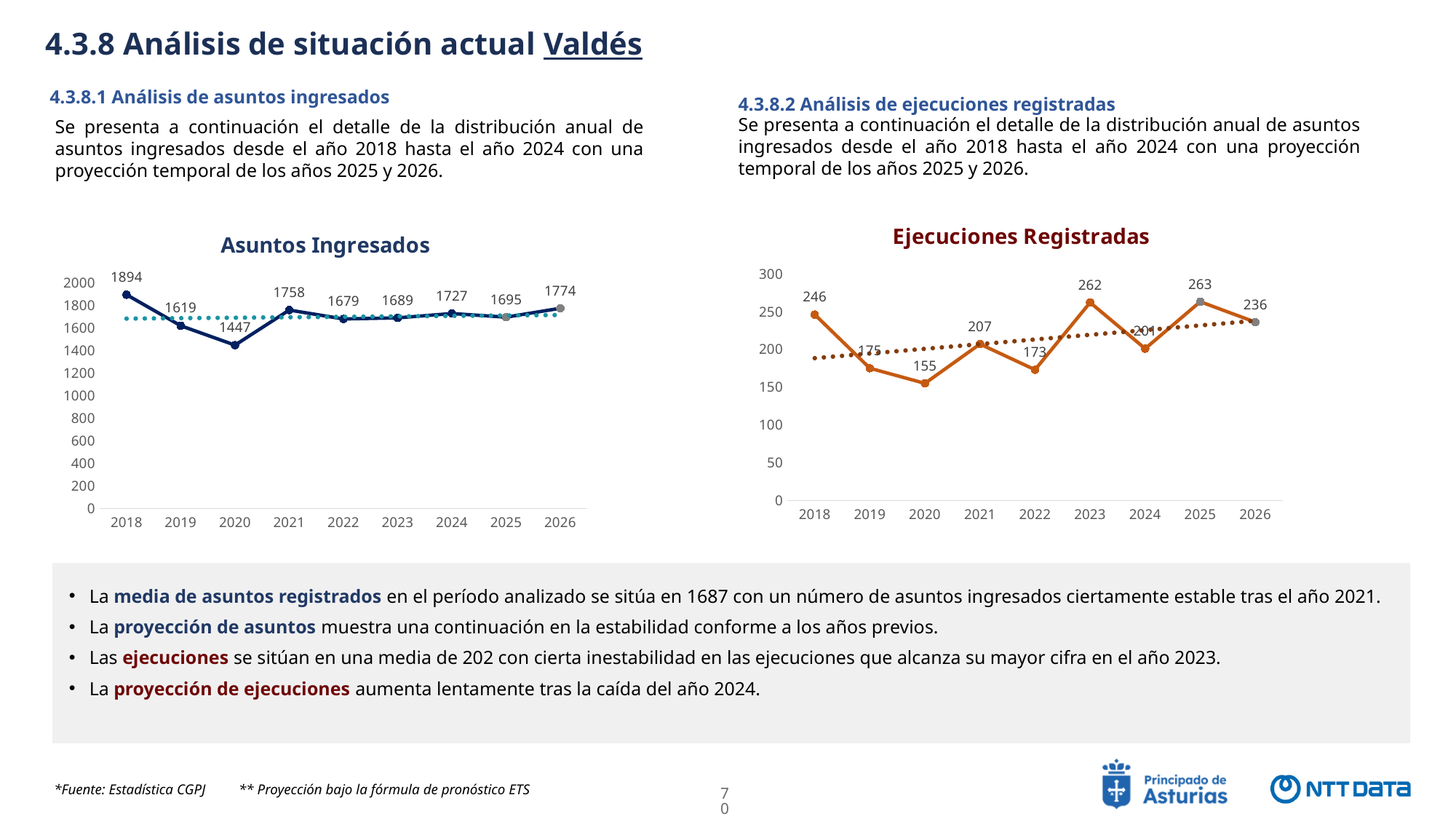
In the 'Asuntos Ingresados' chart, what is the difference between the values for 2018 and 2020? 447 In the 'Ejecuciones Registradas' chart, what is the value for 2023? 262 In the 'Asuntos Ingresados' chart, which year has the lowest value? 2020 In the 'Ejecuciones Registradas' chart, which year has the highest value? 2025 In the 'Asuntos Ingresados' chart, how many years are plotted on the x axis? 9 What kind of chart is the 'Ejecuciones Registradas' chart? Line chart In the 'Asuntos Ingresados' chart, what is the value for 2018? 1894 In the 'Asuntos Ingresados' chart, do the values rise or fall from 2019 to 2020? Fall In the 'Ejecuciones Registradas' chart, what is the difference between the values for 2025 and 2026? 27 In the 'Ejecuciones Registradas' chart, which is larger, the value for 2019 or the value for 2022? 2019 In the 'Ejecuciones Registradas' chart, which year has the lowest value? 2020 In the 'Asuntos Ingresados' chart, is the value for 2021 greater or less than 1600? greater